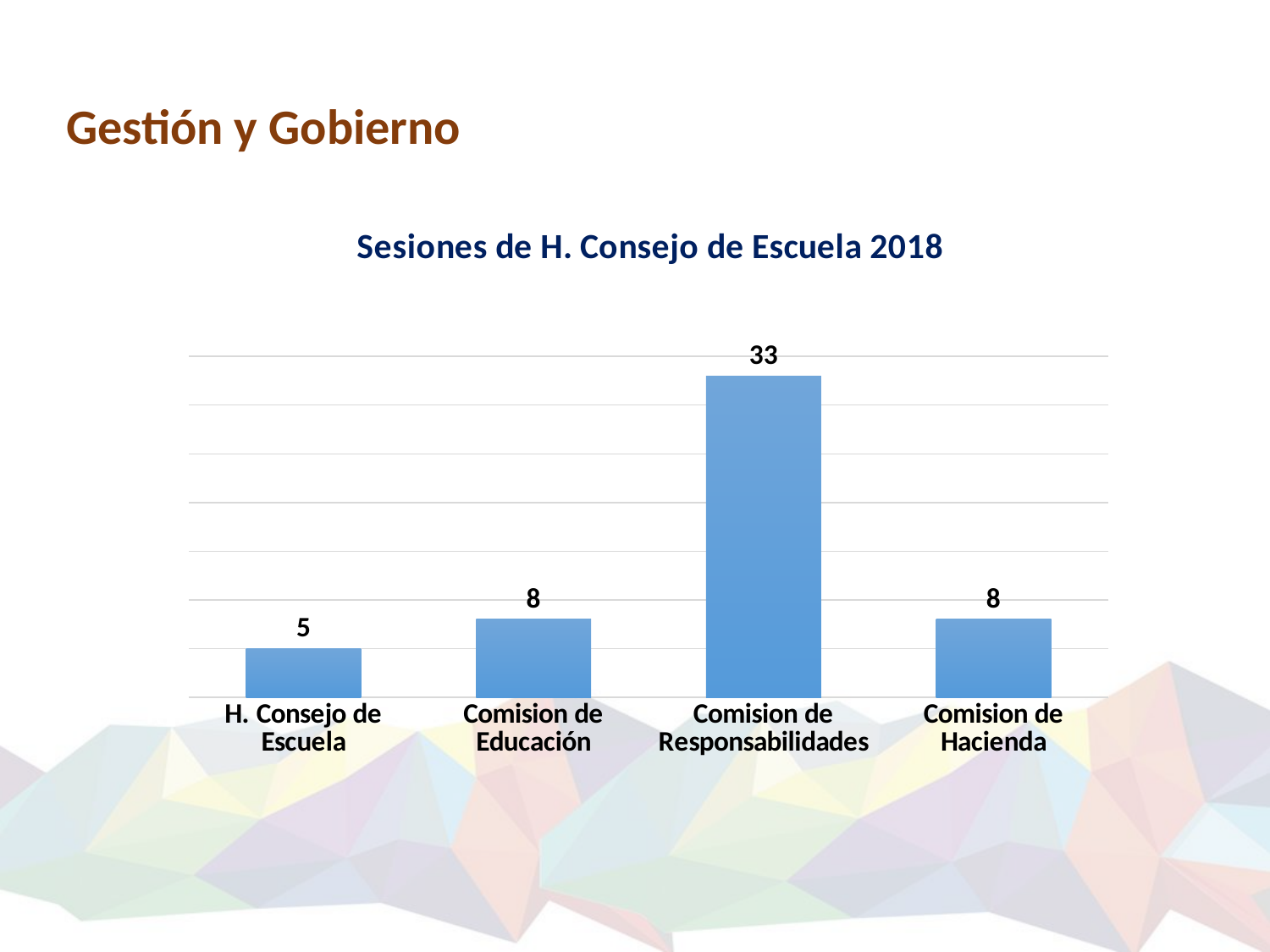
How many categories are shown in the chart? 4 Which is larger, the value for Comision de Educación or the value for H. Consejo de Escuela? Comision de Educación What is the value for Comision de Educación? 8 Which category has the highest value? Comision de Responsabilidades What is the value for H. Consejo de Escuela? 5 Which category has the lowest value? H. Consejo de Escuela What is the title of the chart? Sesiones de H. Consejo de Escuela 2018 What is the value for Comision de Hacienda? 8 What is the difference between the values for Comision de Responsabilidades and Comision de Educación? 25 What is the difference between the values for Comision de Hacienda and H. Consejo de Escuela? 3 What is the value for Comision de Responsabilidades? 33 What kind of chart is shown on the slide? Bar chart